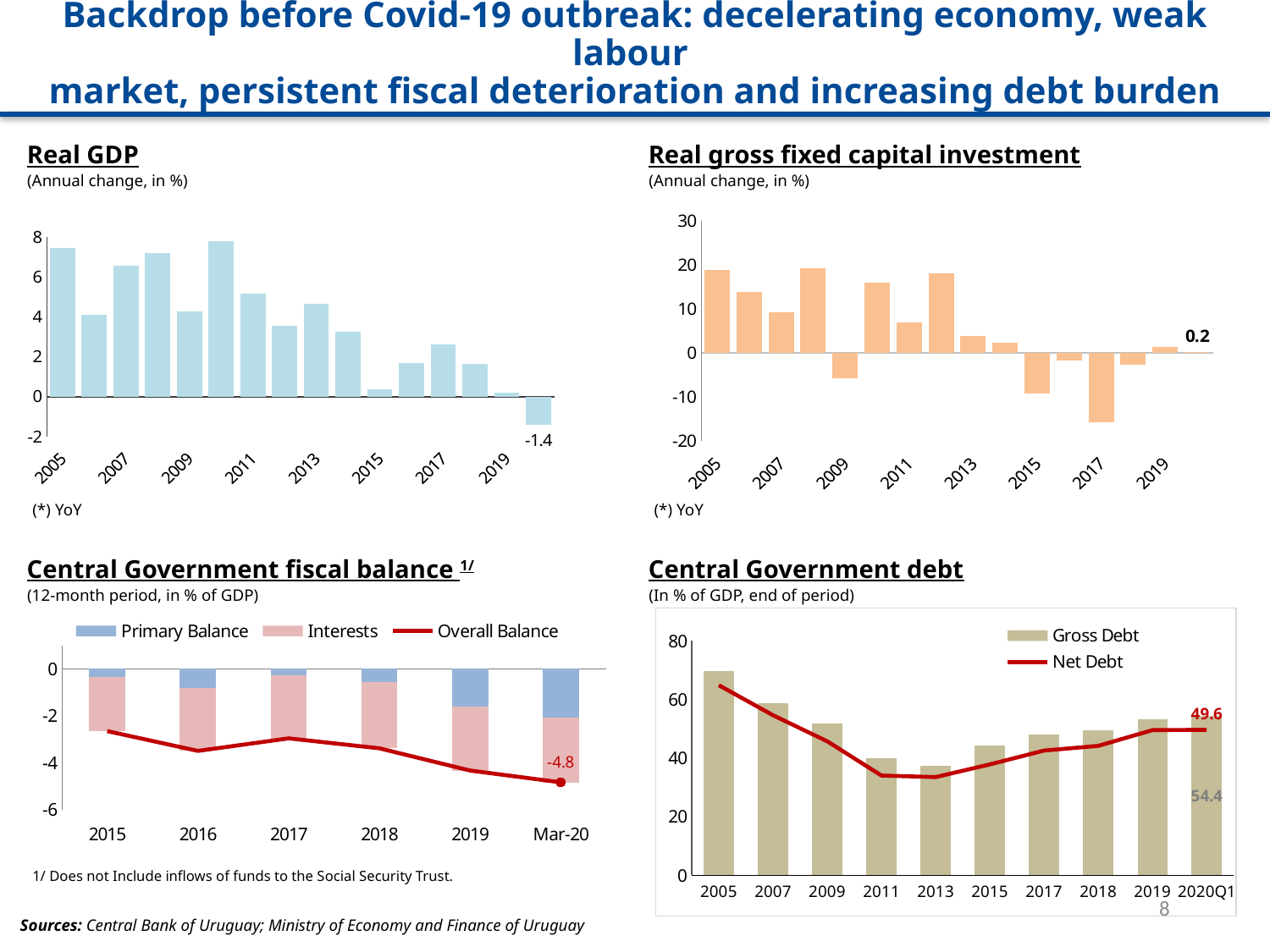
On the Real gross fixed capital investment chart, is the value for 2017 greater or less than -10? less On the Central Government debt chart, which year has the highest Gross Debt? 2005 On the Real gross fixed capital investment chart, what value is labelled on the rightmost bar? 0.2 On the Real GDP chart, what value is labelled on the rightmost bar? -1.4 On the Central Government debt chart, what is the difference between the labelled Gross Debt (54.4) and Net Debt (49.6) values for 2020Q1? 4.8 On the Central Government debt chart, what is the Net Debt value labelled for 2020Q1? 49.6 What type of chart is the Real GDP chart? bar chart On the Real GDP chart, which year has the lowest annual change? 2020 On the Central Government fiscal balance chart, what is the Overall Balance value labelled for Mar-20? -4.8 On the Real GDP chart, is the value for 2005 greater or less than 6? greater On the Real gross fixed capital investment chart, which year has the lowest value? 2017 How many series does the legend of the Central Government fiscal balance chart list? 3